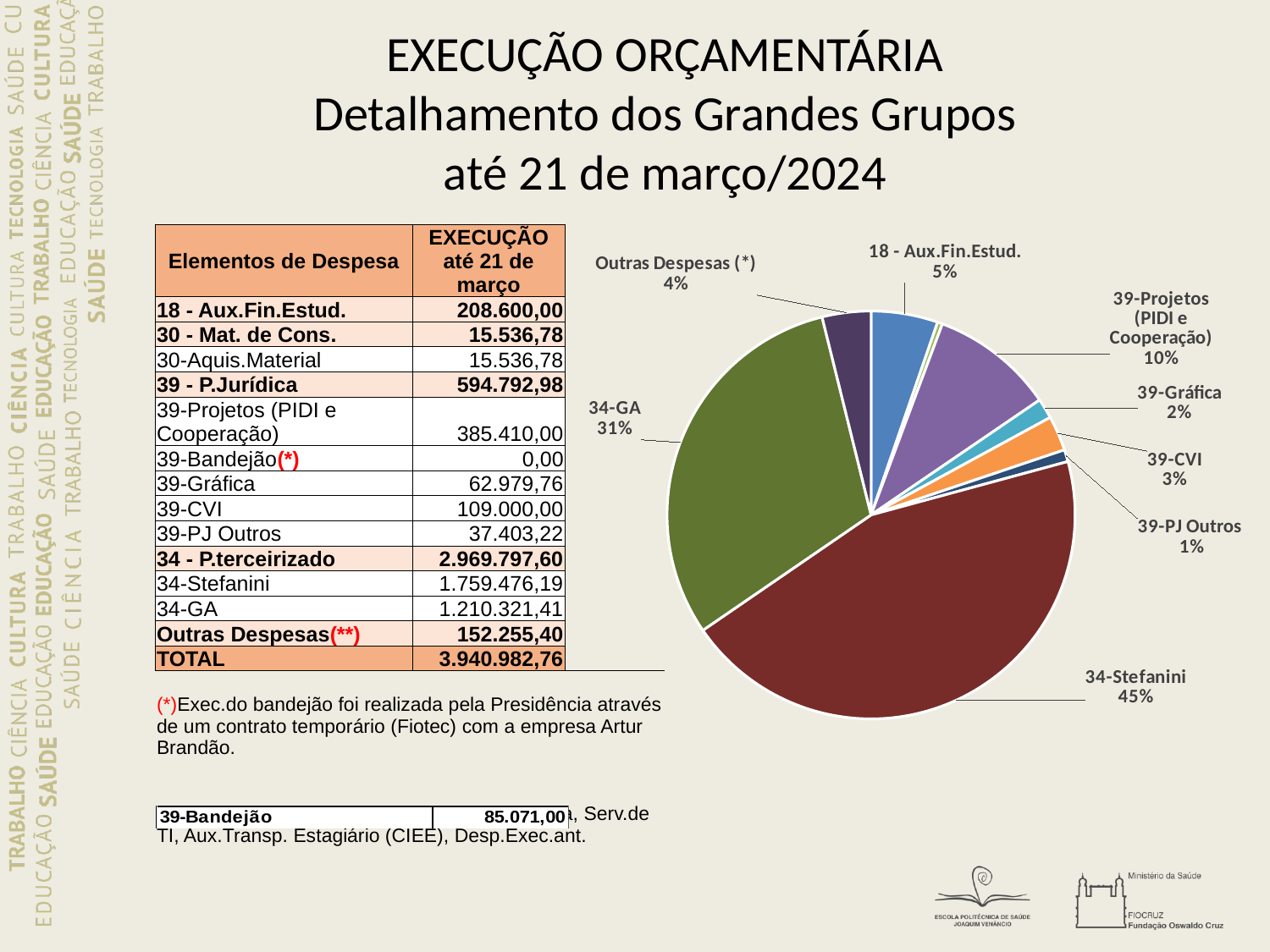
Which is larger, the share for 34-GA or the share for 39-Projetos (PIDI e Cooperação)? 34-GA What is the difference in percentage points between 34-Stefanini and 34-GA? 14 What share of the pie does 34-Stefanini represent? 45% Which slice of the pie is the largest? 34-Stefanini What percentage is shown for Outras Despesas (*)? 4% Which labelled slice of the pie is the smallest? 39-PJ Outros What is the difference in percentage points between 39-Gráfica and 39-PJ Outros? 1 What percentage is shown for 39-CVI? 3% What percentage is shown for 18 - Aux.Fin.Estud.? 5% What kind of chart is shown on the slide? pie chart What share of the pie does 34-GA represent? 31% What percentage is shown for 39-Projetos (PIDI e Cooperação)? 10%